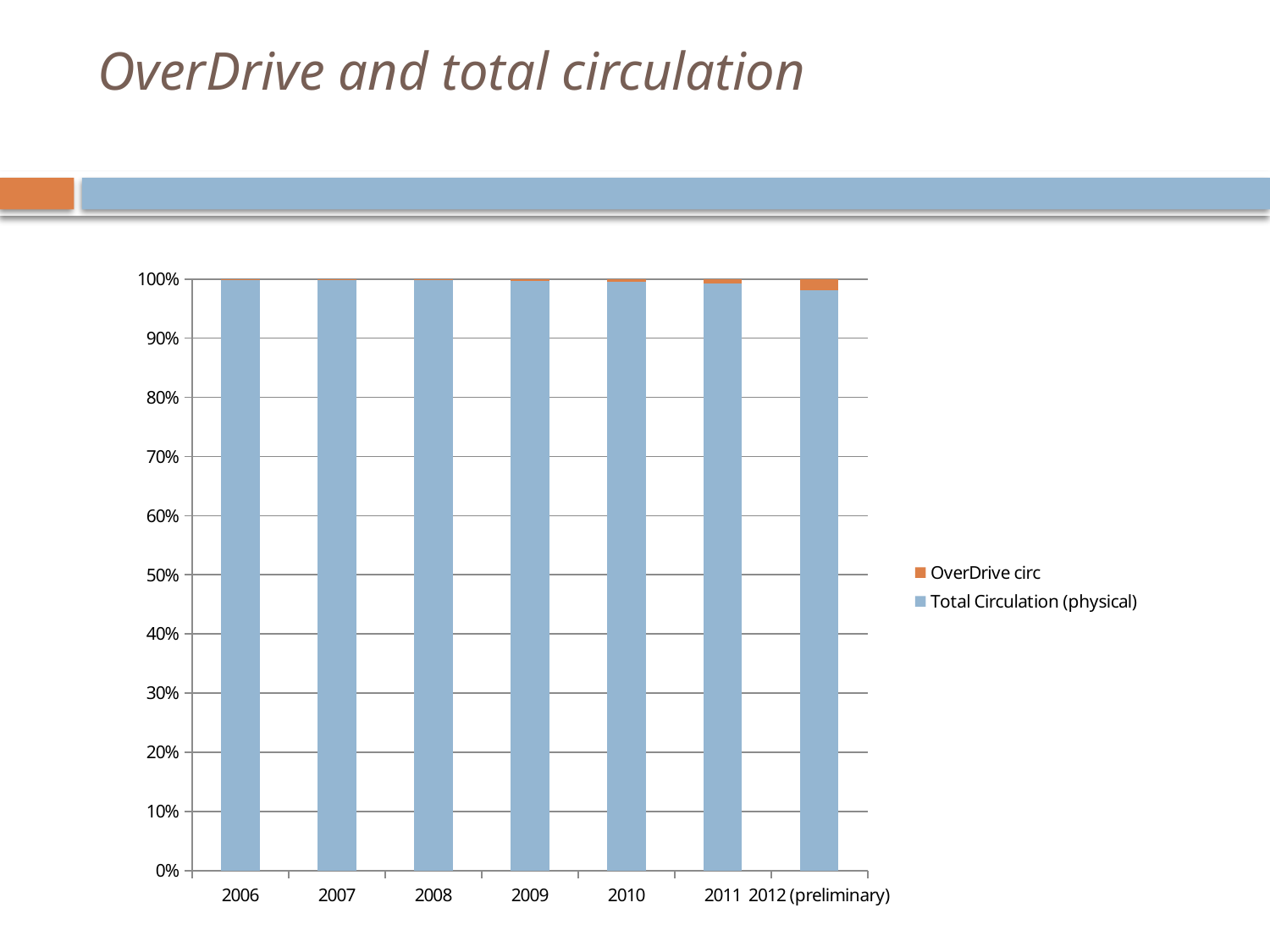
What is the title of the slide containing the chart? OverDrive and total circulation Which year has the largest OverDrive circ share of the bar? 2012 (preliminary) What are the two series named in the chart's legend? OverDrive circ; Total Circulation (physical) Is the OverDrive circ share for 2012 (preliminary) greater or less than 10%? less Which year has the smallest Total Circulation (physical) share of the bar? 2012 (preliminary) What kind of chart is shown on the slide? bar chart How many years (categories) are shown on the x axis of the chart? 7 Is the Total Circulation (physical) share for 2012 (preliminary) greater or less than 90%? greater What is the total height of each stacked bar on the chart? 100% Which is larger in 2011: the OverDrive circ share or the Total Circulation (physical) share? Total Circulation (physical) How many series does the chart's legend list? 2 Does the OverDrive circ share of the bars rise or fall from 2006 to 2012 (preliminary)? rise